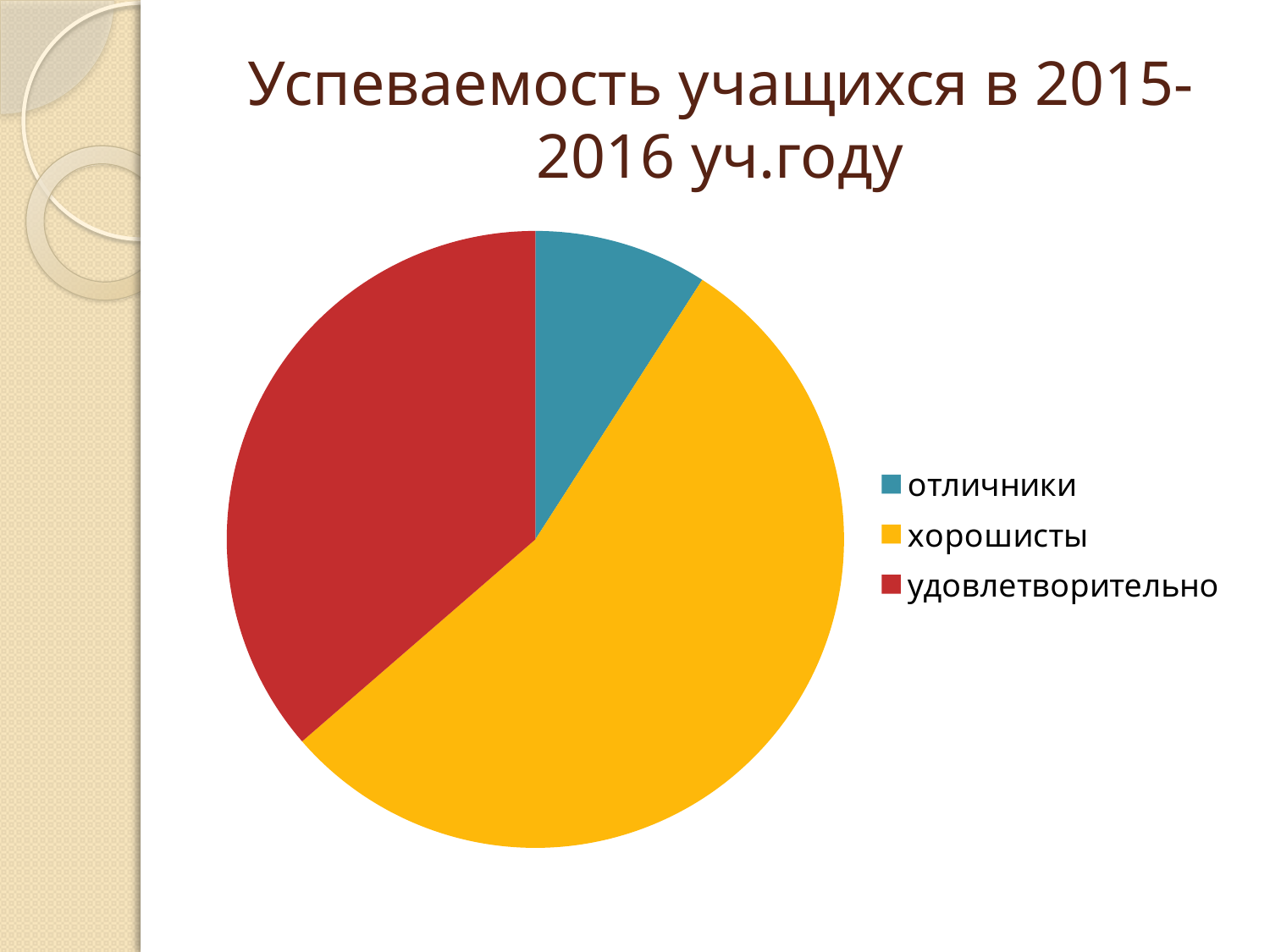
What colour is the slice for удовлетворительно? red How many slices does the pie chart have? 3 Which slice is larger: хорошисты or удовлетворительно? хорошисты Which category has the smallest slice of the pie? отличники Which category has the largest slice of the pie? хорошисты Which slice is larger: отличники or удовлетворительно? удовлетворительно What kind of chart is shown on the slide? pie chart What is the title of the chart on the slide? Успеваемость учащихся в 2015-2016 уч.году Which slice is smaller: отличники or хорошисты? отличники